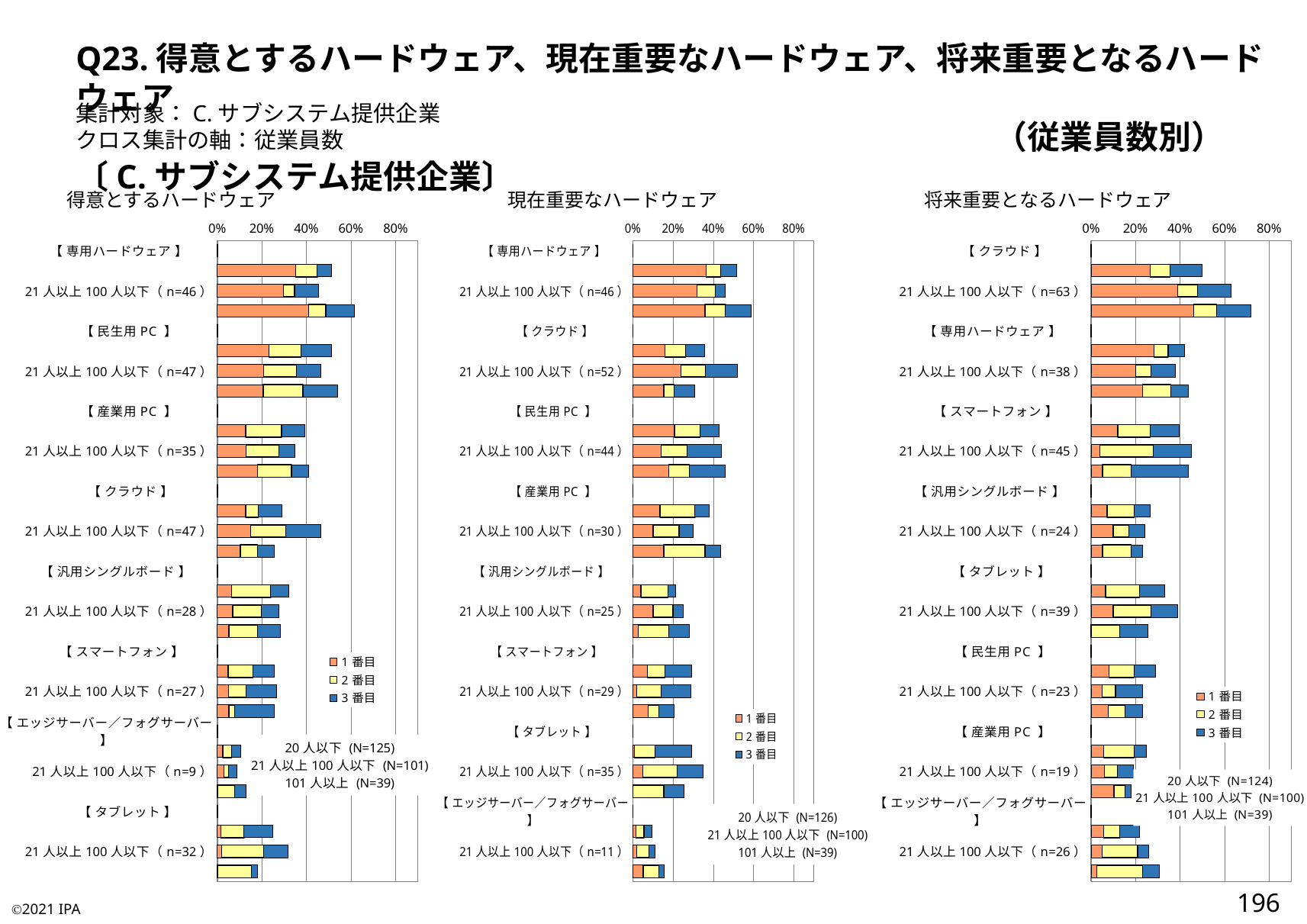
How many series does the legend of the middle chart (現在重要なハードウェア) list? 3 In the right chart (将来重要となるハードウェア), for the 101 人以上 group, which has the larger total stacked value: クラウド or 専用ハードウェア? クラウド What kind of chart is the left chart titled 得意とするハードウェア? stacked bar chart How many hardware categories are shown in the left chart (得意とするハードウェア)? 8 In the right chart (将来重要となるハードウェア), which hardware category has the longest stacked bar for the 101 人以上 group? クラウド In the middle chart (現在重要なハードウェア), is the total stacked value for エッジサーバー／フォグサーバー in the 20 人以下 group greater or less than 20%? less In the left chart (得意とするハードウェア), is the total stacked value for 専用ハードウェア in the 20 人以下 group greater or less than 40%? greater What is the title of the middle chart on the slide? 現在重要なハードウェア In the left chart (得意とするハードウェア), is the total stacked value for エッジサーバー／フォグサーバー in the 21 人以上 100 人以下 (n=9) group greater or less than 20%? less What are the legend entries of the right chart (将来重要となるハードウェア)? 1 番目, 2 番目, 3 番目 In the left chart (得意とするハードウェア), which hardware category has the shortest stacked bars overall? エッジサーバー／フォグサーバー